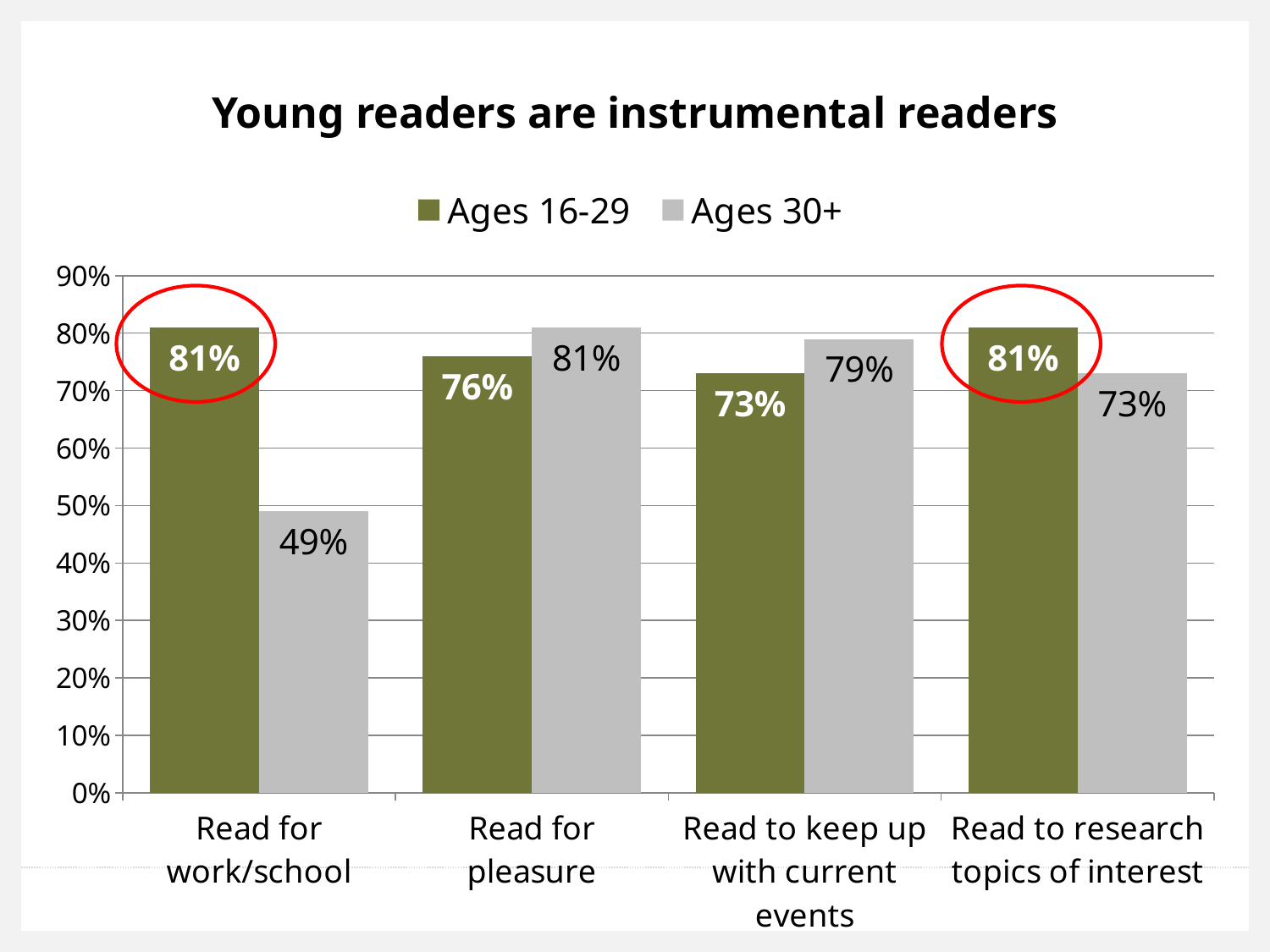
How many categories are shown on the x axis? 4 How many series does the legend list? 2 Which category has the lowest value for Ages 16-29? Read to keep up with current events What is the difference between Ages 16-29 and Ages 30+ for 'Read for work/school'? 32 percentage points What percentage of Ages 16-29 read for work/school? 81% What is the value for Ages 16-29 in the 'Read to keep up with current events' category? 73% For 'Read for pleasure', which age group has the higher value? Ages 30+ Which category has the lowest value for Ages 30+? Read for work/school What percentage of Ages 30+ read for work/school? 49% What is the difference between Ages 30+ and Ages 16-29 for 'Read to keep up with current events'? 6 percentage points What is the value for Ages 30+ in the 'Read for pleasure' category? 81% What type of chart is shown on the slide? Bar chart